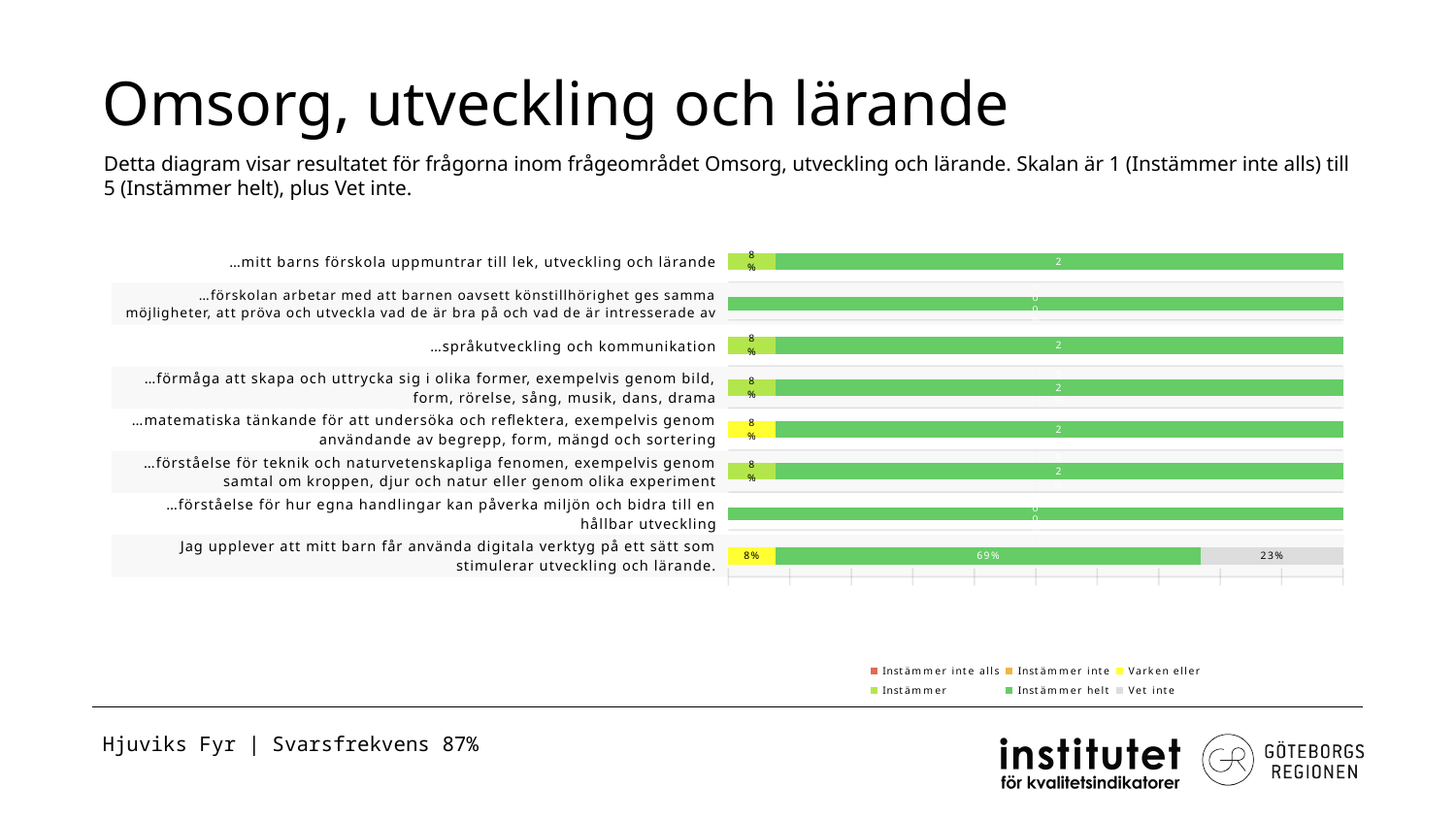
What is the Instämmer helt share for "Jag upplever att mitt barn får använda digitala verktyg på ett sätt som stimulerar utveckling och lärande."? 69% What is the Vet inte share for "Jag upplever att mitt barn får använda digitala verktyg på ett sätt som stimulerar utveckling och lärande."? 23% For "Jag upplever att mitt barn får använda digitala verktyg…", which is larger: the Instämmer helt share or the Vet inte share? Instämmer helt How many series does the legend list? 6 What is the total of the printed segments (8%, 69%, 23%) in the bar for "Jag upplever att mitt barn får använda digitala verktyg…"? 100% What is the Varken eller share for "Jag upplever att mitt barn får använda digitala verktyg på ett sätt som stimulerar utveckling och lärande."? 8% Which category has the lowest Instämmer helt share? Jag upplever att mitt barn får använda digitala verktyg på ett sätt som stimulerar utveckling och lärande. What type of chart is shown on the slide? Bar chart How many question categories (bars) are plotted in the chart? 8 For "Jag upplever att mitt barn får använda digitala verktyg…", what is the difference between the Instämmer helt share (69%) and the Vet inte share (23%)? 46 percentage points What colour represents Vet inte in the legend? Grey